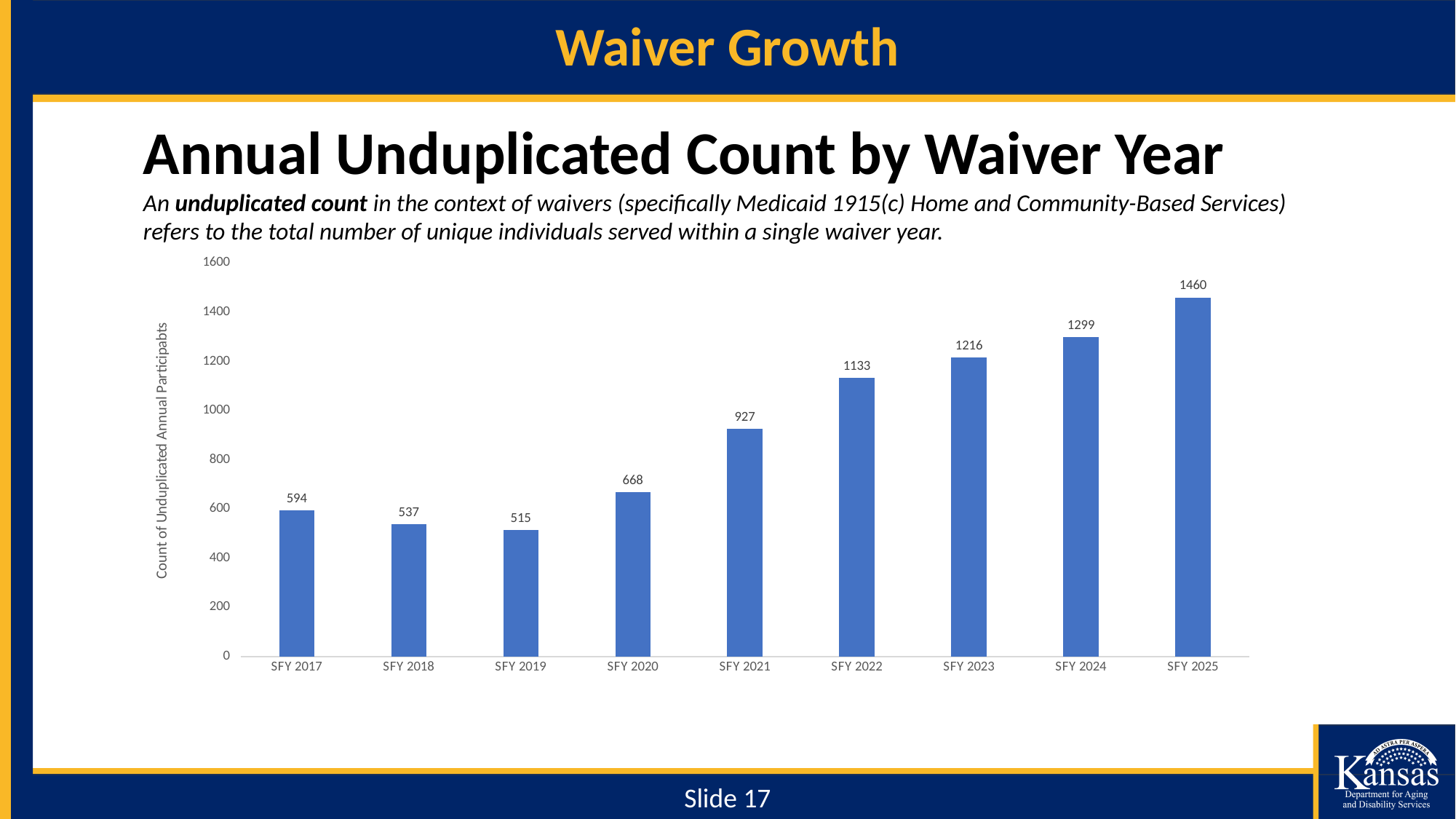
Do the counts generally rise or fall from SFY 2019 to SFY 2025? Rise Which is larger, the count for SFY 2021 or the count for SFY 2022? SFY 2022 Which waiver year has the lowest count of unduplicated annual participants? SFY 2019 What is the count of unduplicated annual participants for SFY 2023? 1216 What kind of chart is shown on the slide? Bar chart What is the difference between the counts for SFY 2025 and SFY 2024? 161 Which waiver year has the highest count of unduplicated annual participants? SFY 2025 Is the value for SFY 2021 greater or less than 800? greater How many waiver years are shown on the chart? 9 What is the label of the vertical axis of the chart? Count of Unduplicated Annual Participabts What is the count of unduplicated annual participants for SFY 2020? 668 What is the difference between the counts for SFY 2017 and SFY 2018? 57